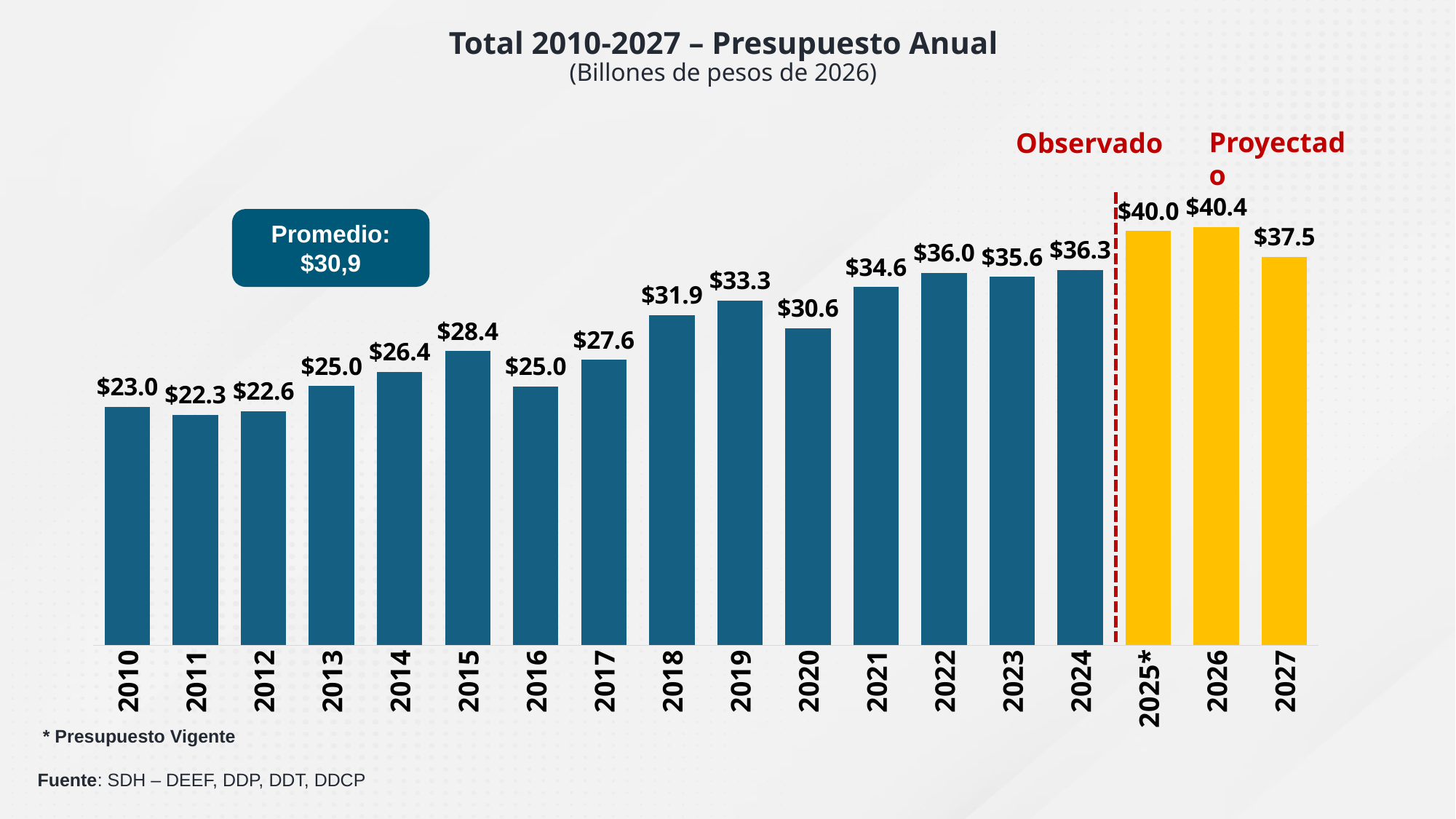
Which years are shown in yellow as projected (Proyectado)? 2025*, 2026, 2027 How many years are shown on the x axis? 18 Which year has the lowest value? 2011 What is the value for 2027? $37.5 What is the difference between the values for 2024 and 2010? $13.3 Which is larger, the value for 2022 or the value for 2023? 2022 Which year has the highest value? 2026 What is the value for 2011? $22.3 What average (Promedio) is shown in the box on the chart? $30,9 Do the values generally rise or fall from 2010 to 2026? Rise What kind of chart is this? Bar chart What is the value for 2018? $31.9